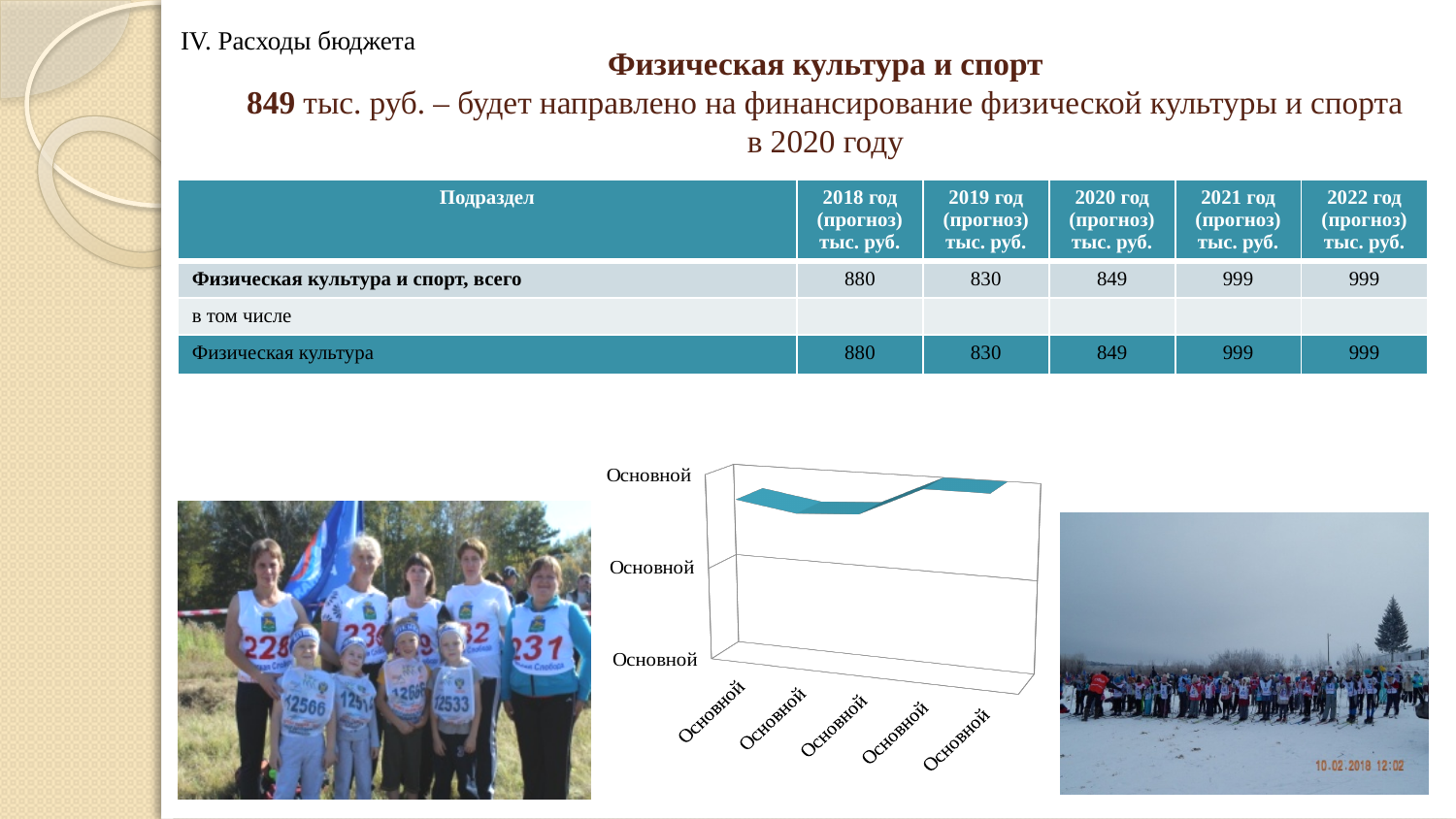
Does the line in the chart rise or fall between the third and the fifth category? rise What kind of chart is shown on the slide? line chart Does the line in the chart rise or fall between the first and the third category? fall Does the chart display a legend? No How many categories are plotted along the x axis of the chart? 5 What text is used for every category label on the x axis of the chart? Основной How many tick labels are shown on the vertical axis of the chart? 3